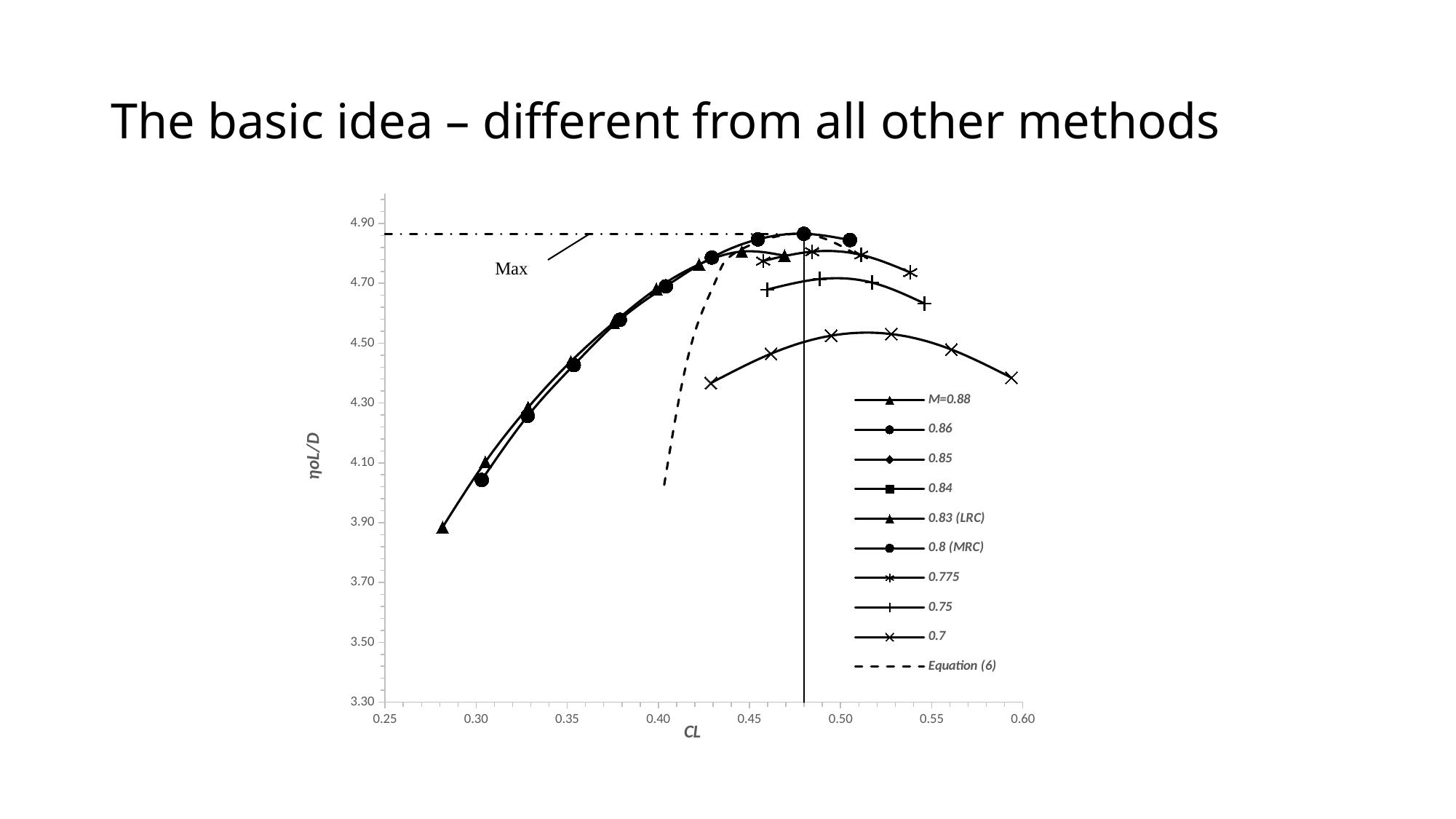
What is the title of the x axis? CL Is the lowest plotted value on the chart greater or less than 4.10? less What is the title of the y axis? ηoL/D How many series does the legend list? 10 What kind of chart is shown on the slide? line chart Which series reaches higher values, 0.75 or 0.7? 0.75 Is the lowest value of the 0.75 series greater or less than 4.50? greater How many data points are plotted for the 0.7 series? 6 Is the highest value of the 0.775 series greater or less than 4.70? greater Which series is drawn with a dashed line according to the legend? Equation (6) Which series has the lowest peak value on the chart? 0.7